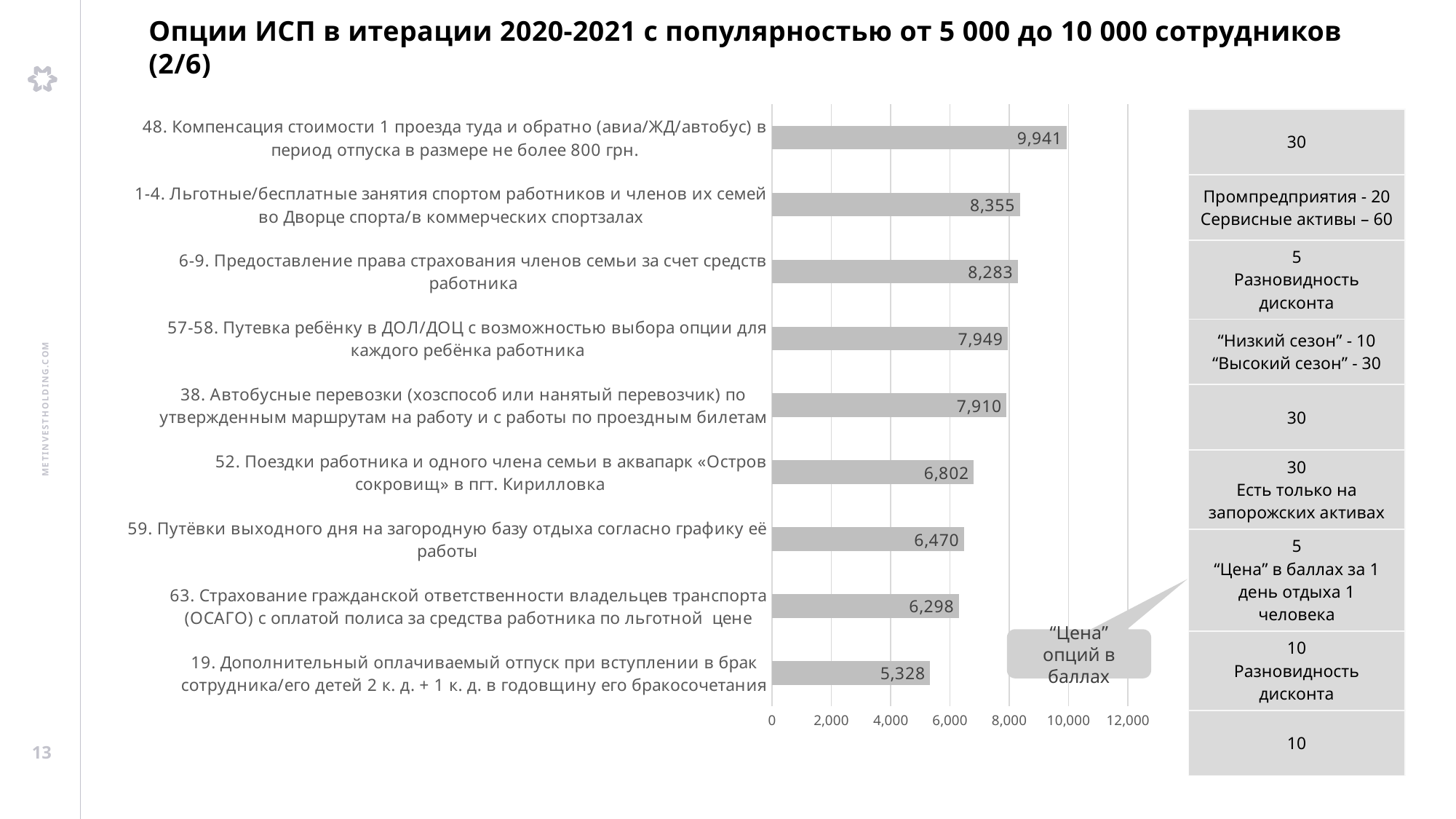
Which has a larger value: option 59 (Путёвки выходного дня) or option 63 (Страхование ОСАГО)? 59. Путёвки выходного дня How many categories (options) are plotted in the bar chart? 9 What is the value for option 48 (Компенсация стоимости 1 проезда туда и обратно в период отпуска)? 9,941 Is the value for option 38 (Автобусные перевозки) greater or less than 6,000? greater What is the maximum value shown on the horizontal axis of the chart? 12,000 What type of chart is shown on the slide? bar chart What is the value for options 57-58 (Путевка ребёнку в ДОЛ/ДОЦ)? 7,949 Which option has the lowest value in the chart? 19. Дополнительный оплачиваемый отпуск при вступлении в брак Which option has the highest value in the chart? 48. Компенсация стоимости 1 проезда туда и обратно (авиа/ЖД/автобус) в период отпуска What is the difference between the values for option 48 (9,941) and option 19 (5,328)? 4,613 What is the value for option 19 (Дополнительный оплачиваемый отпуск при вступлении в брак)? 5,328 What is the value for option 52 (Поездки работника и одного члена семьи в аквапарк «Остров сокровищ»)? 6,802